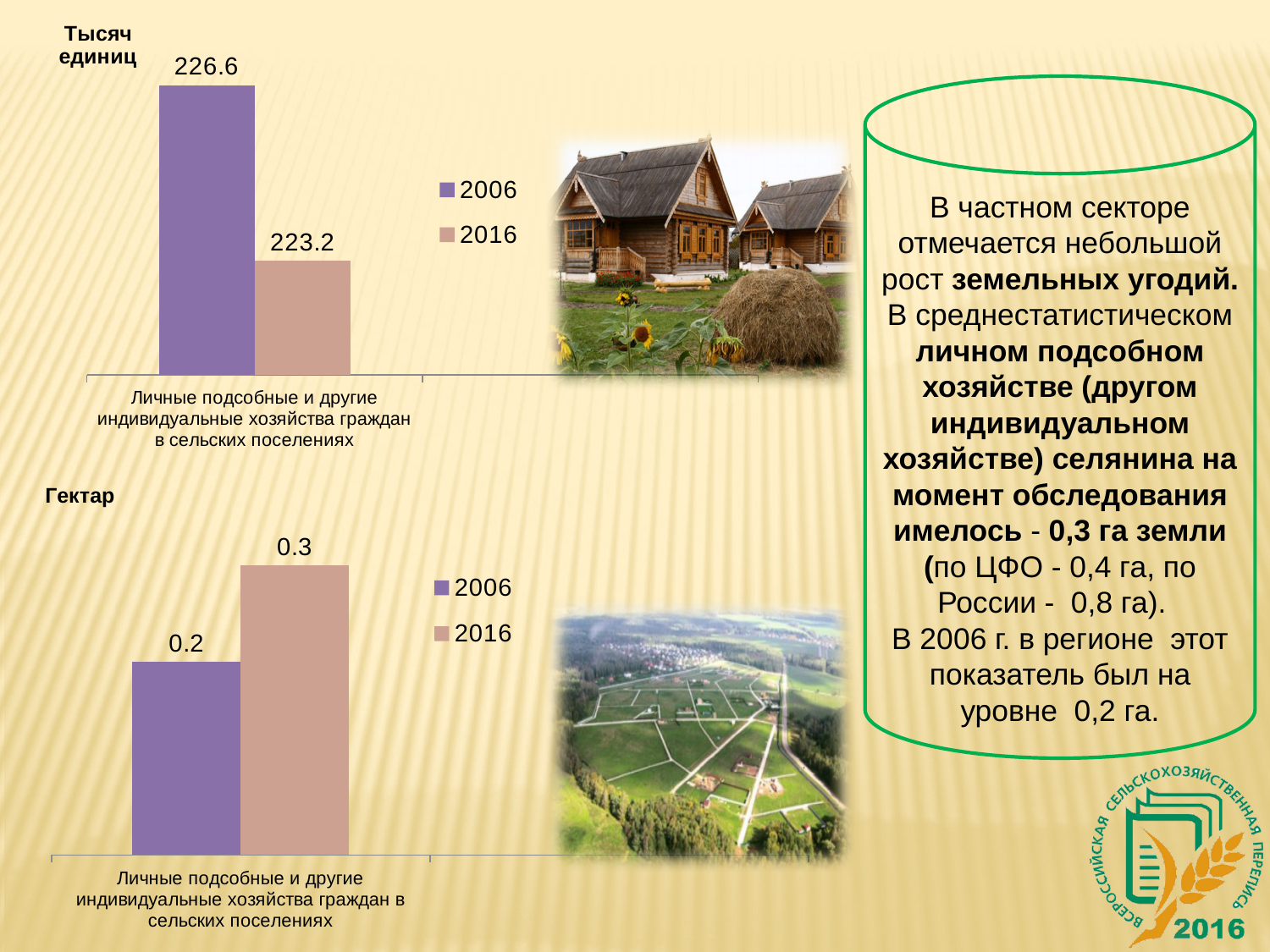
In the bottom chart (Гектар), does the value rise or fall from 2006 to 2016? Rise What kind of chart is the bottom chart (Гектар)? Bar chart In the top chart (Тысяч единиц), what is the difference between the 2006 and 2016 values? 3.4 In the bottom chart (Гектар), what is the value for 2006? 0.2 In the top chart (Тысяч единиц), which year has the higher value, 2006 or 2016? 2006 In the bottom chart (Гектар), what is the difference between the 2016 and 2006 values? 0.1 In the top chart (Тысяч единиц), what is the value for 2016? 223.2 In the bottom chart (Гектар), what is the value for 2016? 0.3 In the bottom chart (Гектар), which year has the higher value, 2006 or 2016? 2016 How many series does the legend of the top chart (Тысяч единиц) list? 2 In the top chart (Тысяч единиц), what is the value for 2006? 226.6 In the top chart (Тысяч единиц), which colour represents the 2016 series? Pinkish-brown (tan)